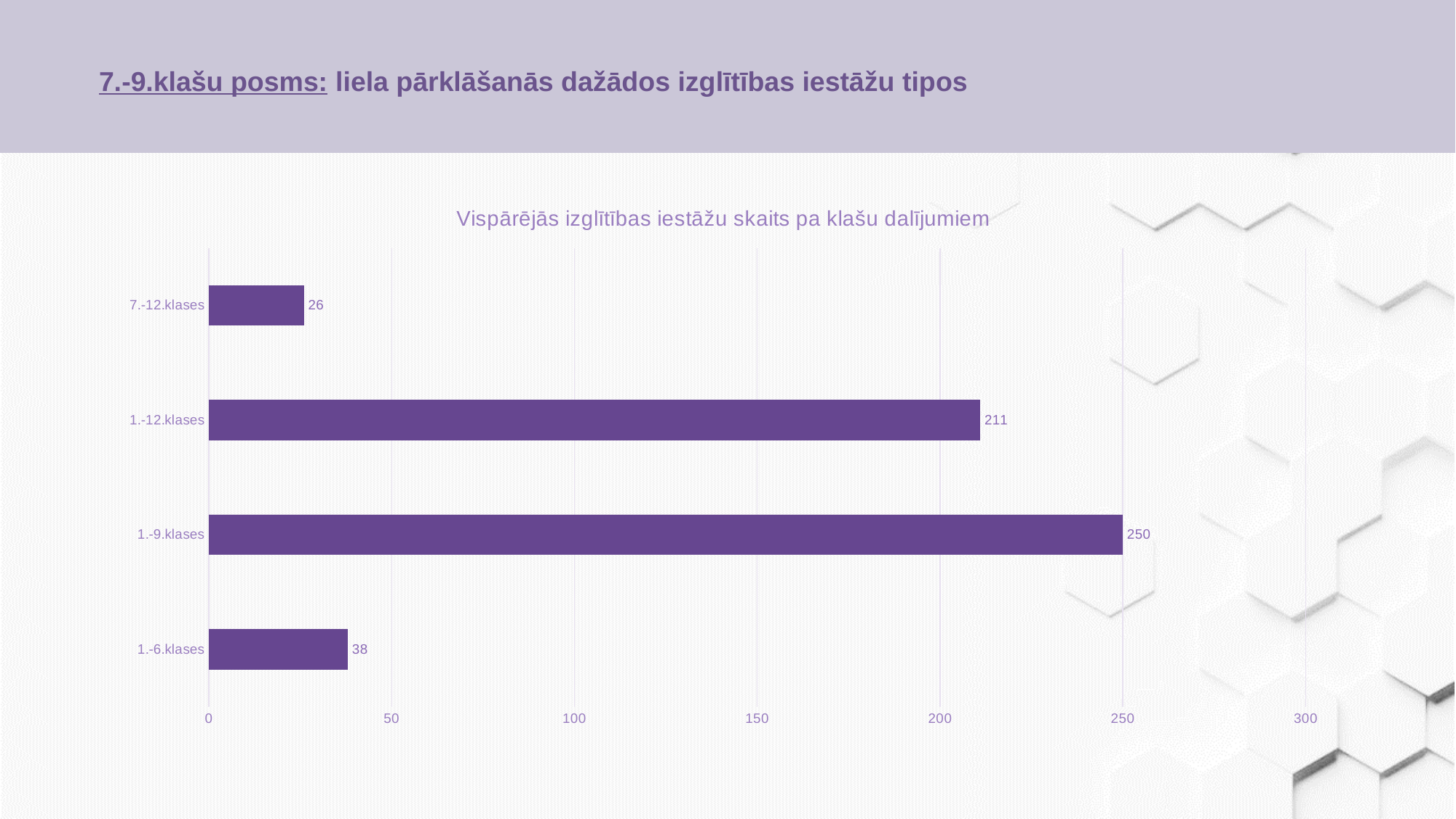
What is the title of the chart? Vispārējās izglītības iestāžu skaits pa klašu dalījumiem What is the difference between the values for 1.-6.klases and 7.-12.klases? 12 What is the value for 1.-9.klases? 250 What is the value for 7.-12.klases? 26 Which category has the highest value? 1.-9.klases Which is larger, the value for 1.-6.klases or the value for 7.-12.klases? 1.-6.klases What is the value for 1.-6.klases? 38 What is the difference between the values for 1.-9.klases and 1.-12.klases? 39 What is the value for 1.-12.klases? 211 Which category has the lowest value? 7.-12.klases How many categories are shown in the chart? 4 What kind of chart is shown on the slide? bar chart